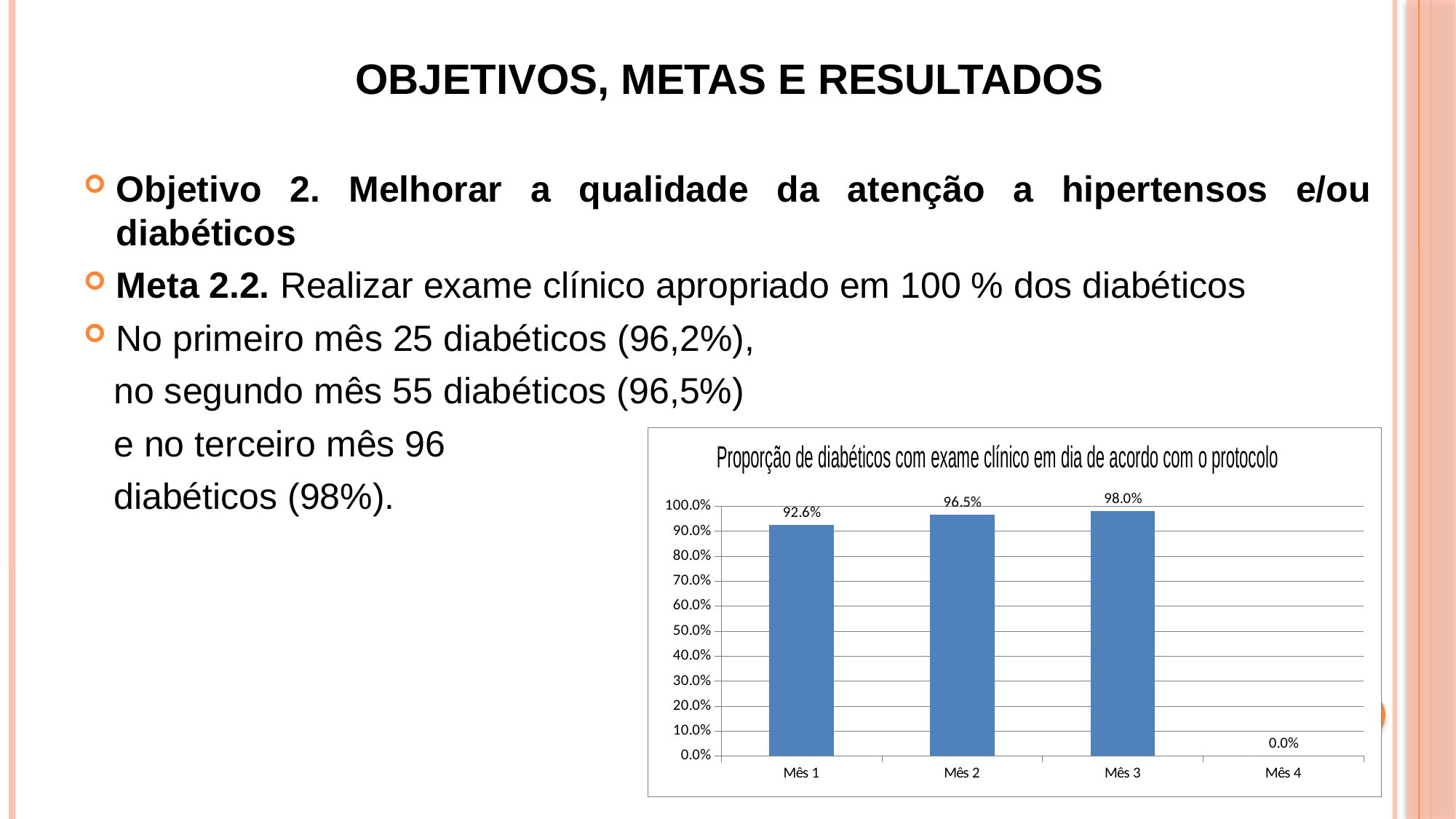
Which month has the lowest value in the chart? Mês 4 What is the title of the chart? Proporção de diabéticos com exame clínico em dia de acordo com o protocolo What is the value for Mês 4 in the chart? 0.0% What is the difference between the values for Mês 3 and Mês 1? 5.4% Which is larger, the value for Mês 2 or the value for Mês 1? Mês 2 Is the value for Mês 1 greater or less than 90.0%? greater Which month has the highest value in the chart? Mês 3 How many categories are shown on the x axis of the chart? 4 What is the value for Mês 1 in the chart? 92.6% What is the value for Mês 3 in the chart? 98.0% What kind of chart is shown on the slide? bar chart What is the value for Mês 2 in the chart? 96.5%